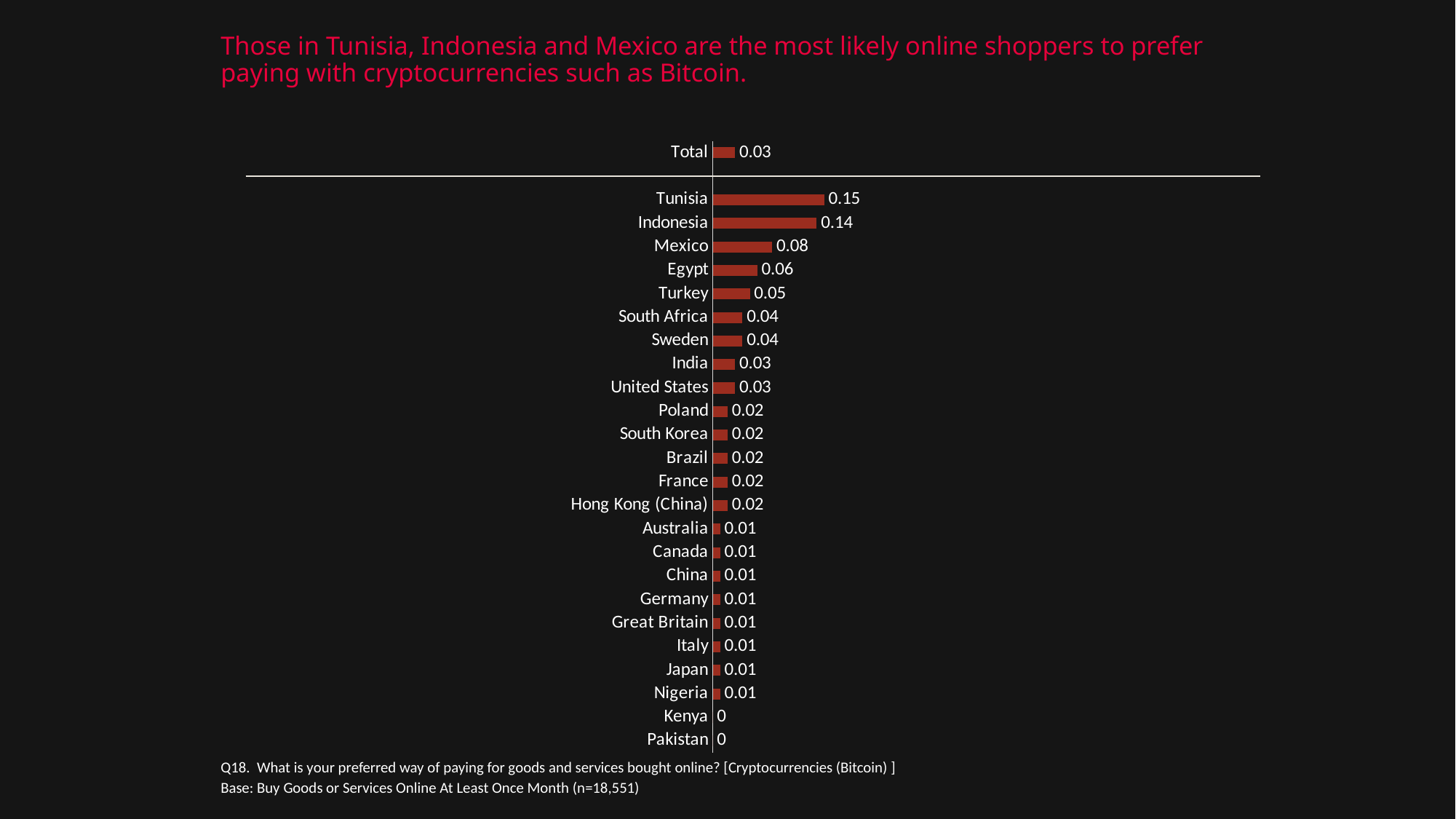
Which has a larger value, Turkey or South Africa? Turkey What is the difference between the values for Tunisia and Indonesia? 0.01 What is the difference between the values for Mexico and Egypt? 0.02 What is the value for Mexico? 0.08 What is the value for Tunisia? 0.15 What is the value for Sweden? 0.04 Which two countries show a value of 0? Kenya and Pakistan How many countries are listed below the Total bar? 24 What is the value shown for Total? 0.03 What kind of chart is shown on the slide? Bar chart Which country has the highest value? Tunisia Which has a larger value, Egypt or Poland? Egypt